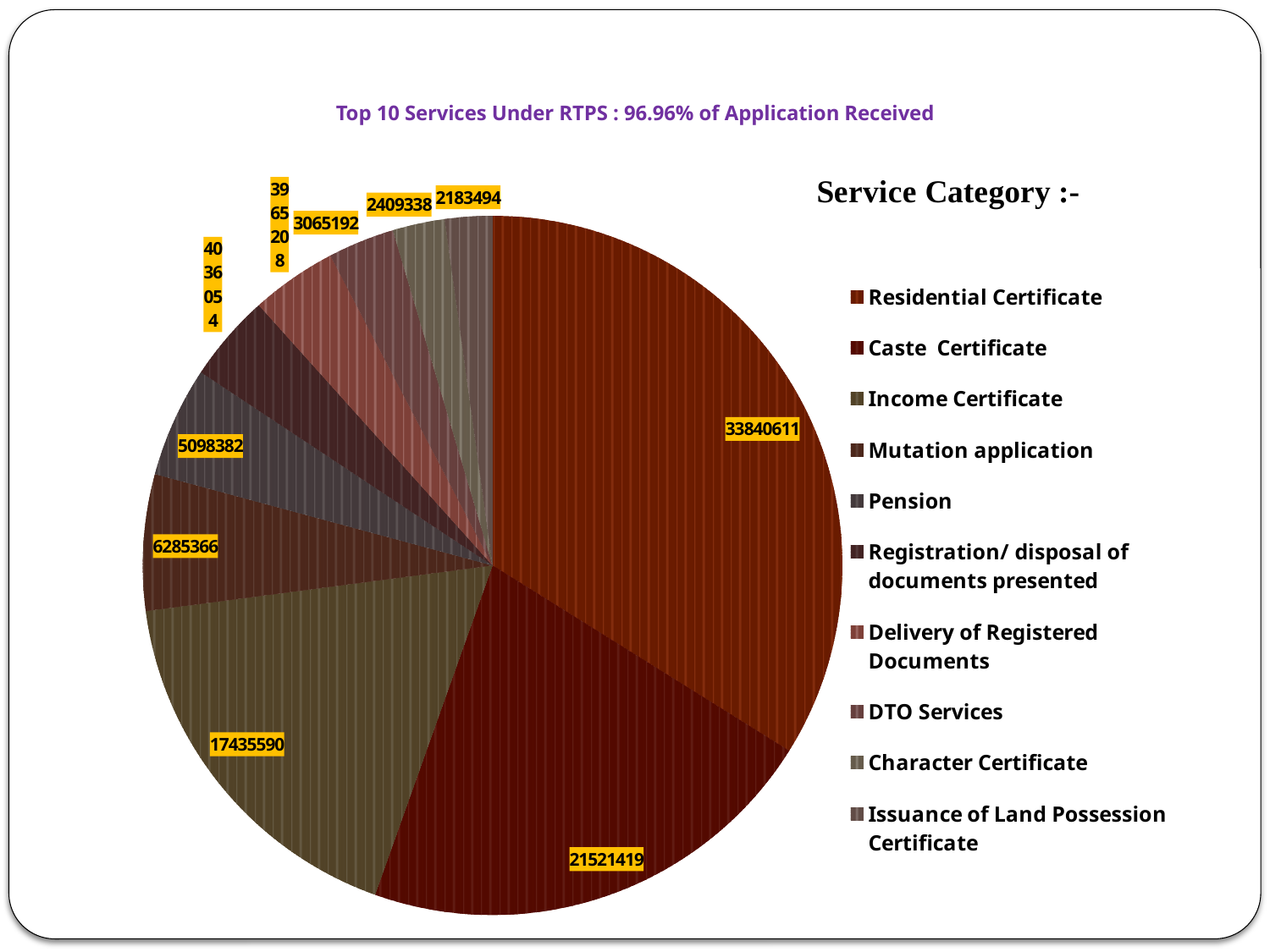
Which service category has the largest slice? Residential Certificate What is the difference between the values for Residential Certificate and Caste Certificate? 12319192 Which service category has the smallest slice? Issuance of Land Possession Certificate What is the value for Caste Certificate? 21521419 What is the title of the chart? Top 10 Services Under RTPS : 96.96% of Application Received How many service categories does the legend list? 10 Which is larger, the value for DTO Services or the value for Character Certificate? DTO Services What is the value for Residential Certificate? 33840611 What is the value for Income Certificate? 17435590 What kind of chart is shown on the slide? pie chart What is the value for Pension? 5098382 What is the value for Mutation application? 6285366